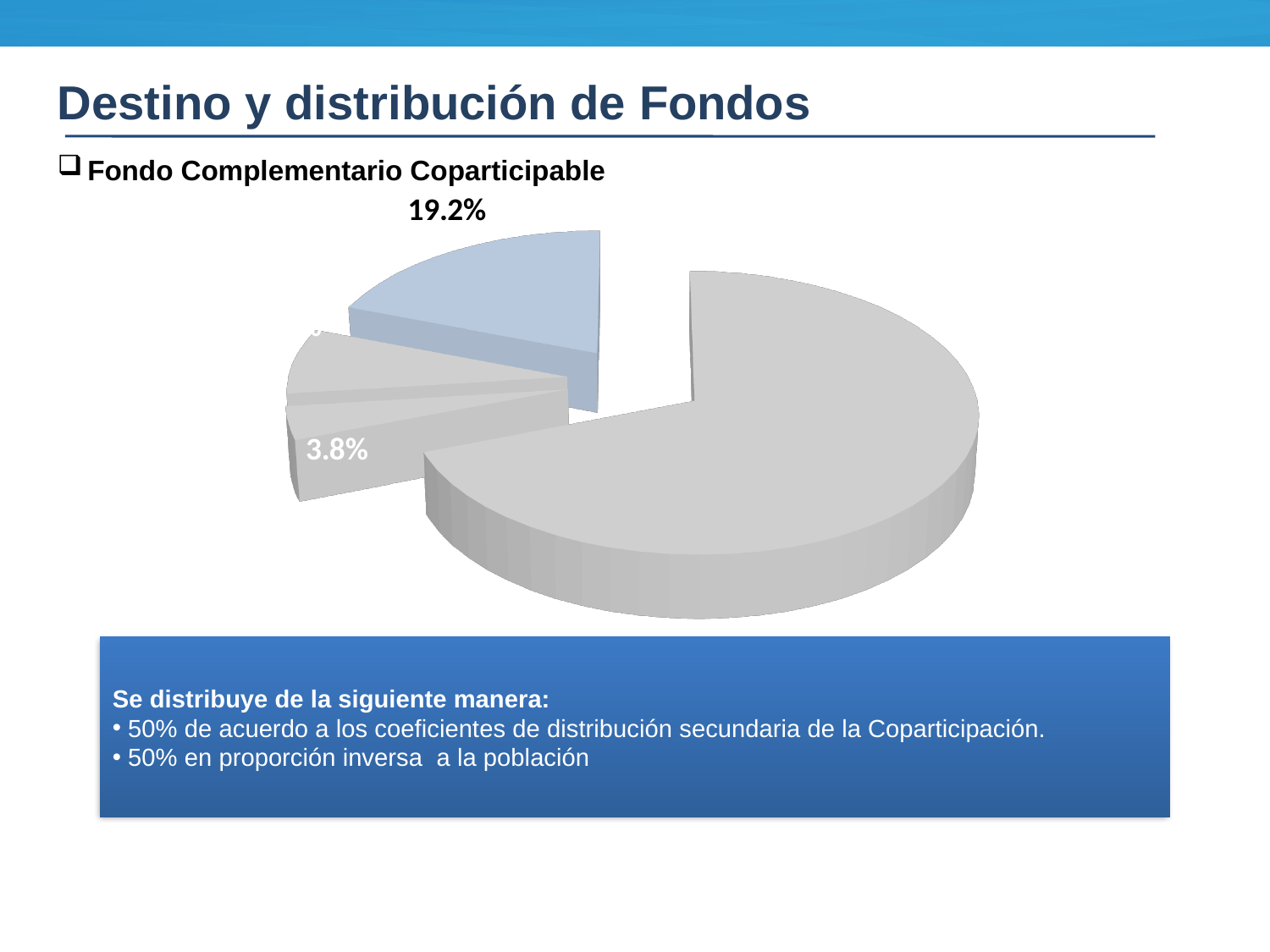
What percentage is shown on the blue slice of the pie chart? 19.2% What is the smallest percentage printed as a data label on the pie chart? 3.8% Is the large grey slice of the pie chart greater or less than 50% of the pie? greater Which is larger, the blue slice labelled 19.2% or the grey slice labelled 3.8%? The blue slice (19.2%) What colour is the slice labelled 19.2%? Blue How many slices does the pie chart have? 4 What kind of chart is shown on the slide? Pie chart What is the difference between the 19.2% slice and the 3.8% slice? 15.4 percentage points What is the heading shown above the pie chart? Fondo Complementario Coparticipable Which slice of the pie chart is the largest? The large grey slice